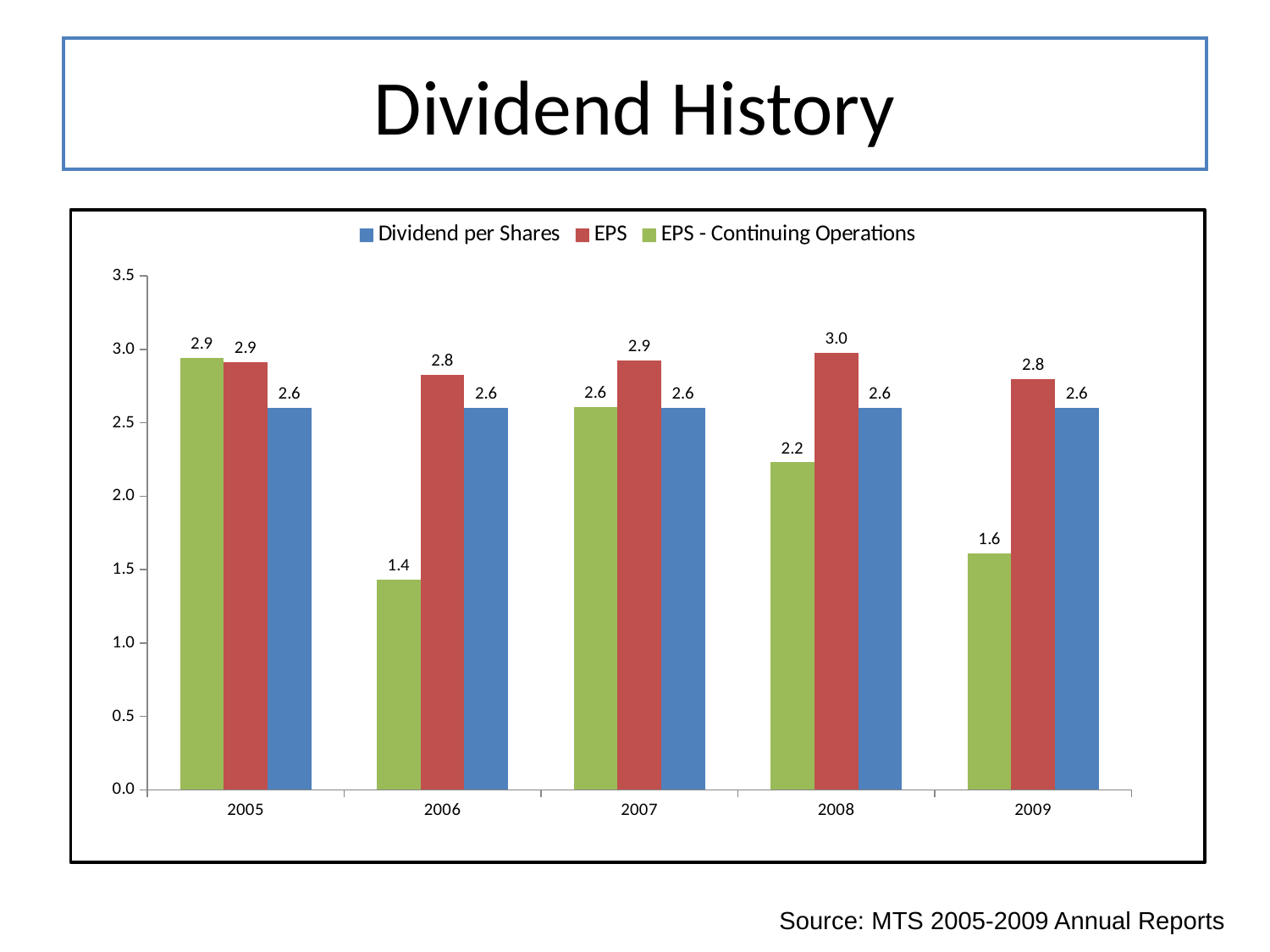
What is the Dividend per Shares value for 2009? 2.6 What kind of chart is shown on the slide? bar chart Is the EPS - Continuing Operations value for 2008 greater or less than 2.5? less What is the difference between EPS and EPS - Continuing Operations in 2009? 1.2 What is the EPS - Continuing Operations value for 2006? 1.4 How many series does the legend list? 3 Which is larger in 2008: EPS or Dividend per Shares? EPS What is the EPS value for 2008? 3.0 Which colour represents EPS in the chart? red In which year is EPS - Continuing Operations lowest? 2006 In which year is EPS highest? 2008 How many years are shown on the x axis? 5